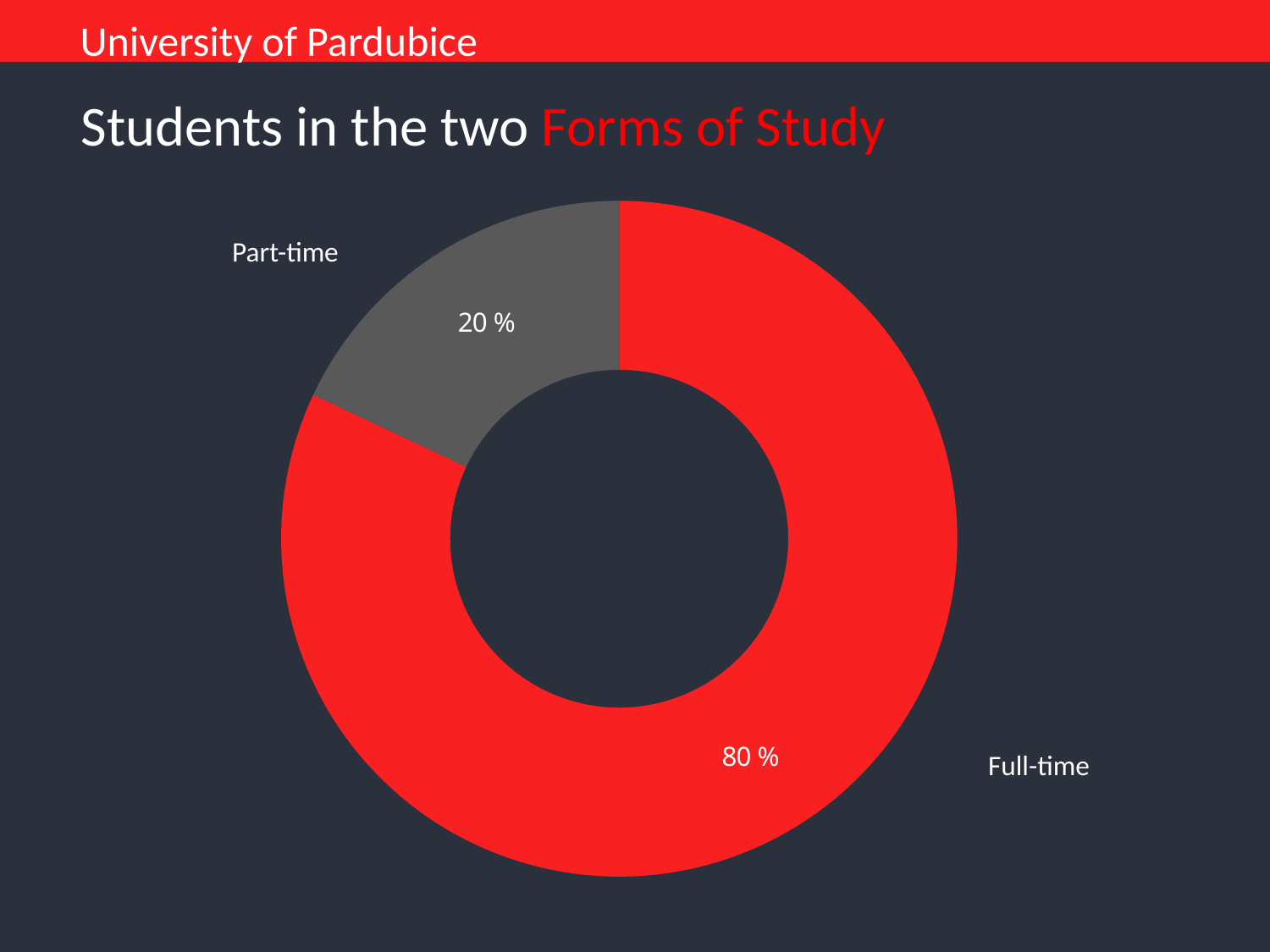
What is the difference in percentage points between the Full-time and Part-time shares? 60 What share of the chart does the Part-time slice represent? 20 % What is the title of the slide containing the chart? Students in the two Forms of Study What kind of chart is shown on the slide? doughnut chart What colour is the Full-time slice? red What percentage of students are Part-time? 20 % Which form of study has the smaller share of students? Part-time How many categories does the chart show? 2 Which form of study has the larger share of students? Full-time Is the share for Full-time larger or smaller than the share for Part-time? larger What percentage of students are Full-time? 80 %